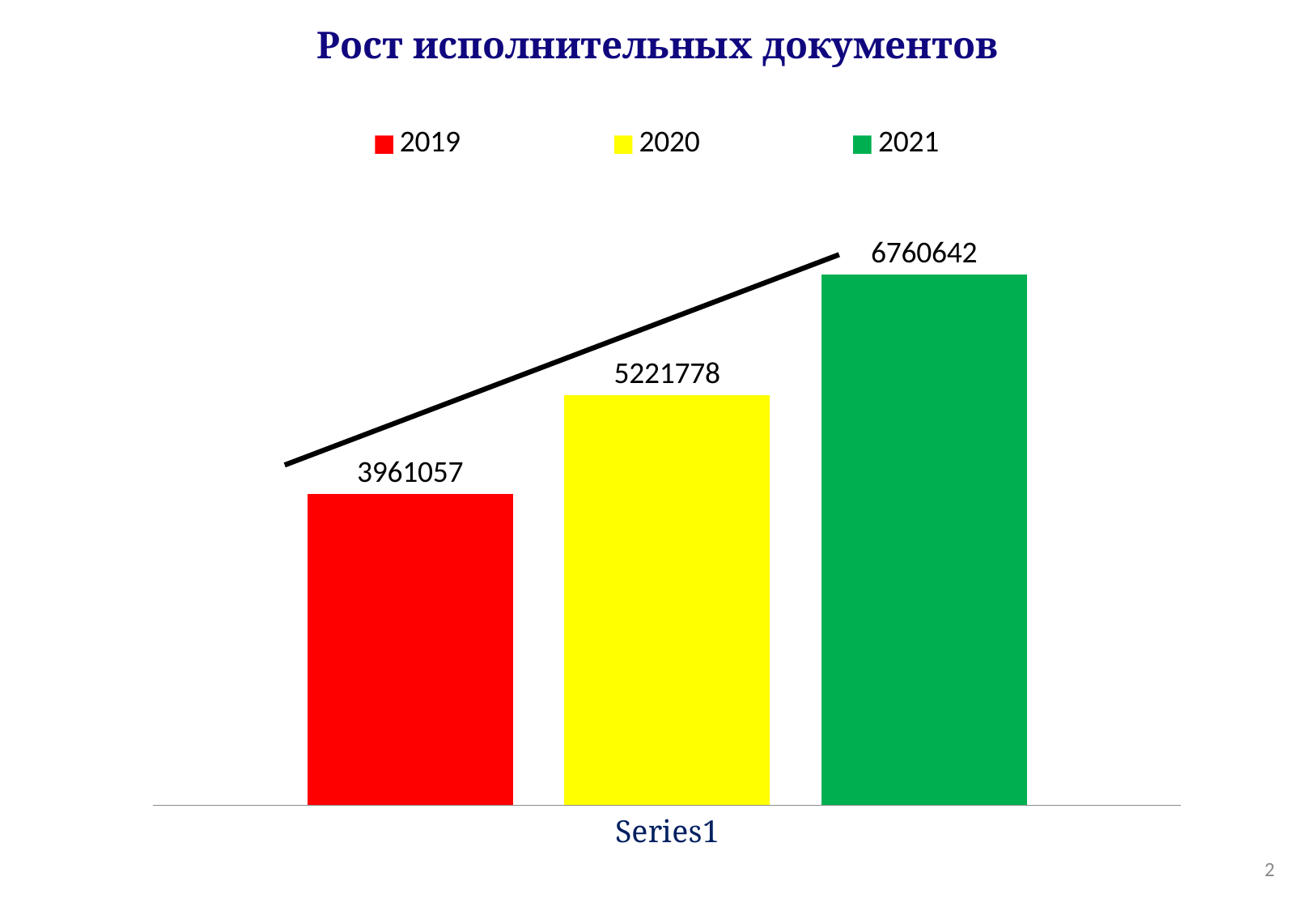
What is the difference between the values for 2021 and 2019? 2799585 What is the value shown for 2019? 3961057 What is the value shown for 2020? 5221778 What is the title of the chart? Рост исполнительных документов Which year has the lowest value? 2019 What is the difference between the values for 2020 and 2019? 1260721 What is the difference between the values for 2021 and 2020? 1538864 Which is larger, the value for 2020 or the value for 2019? 2020 How many series does the legend list? 3 Which year has the highest value? 2021 What is the value shown for 2021? 6760642 What kind of chart is shown on the slide? bar chart